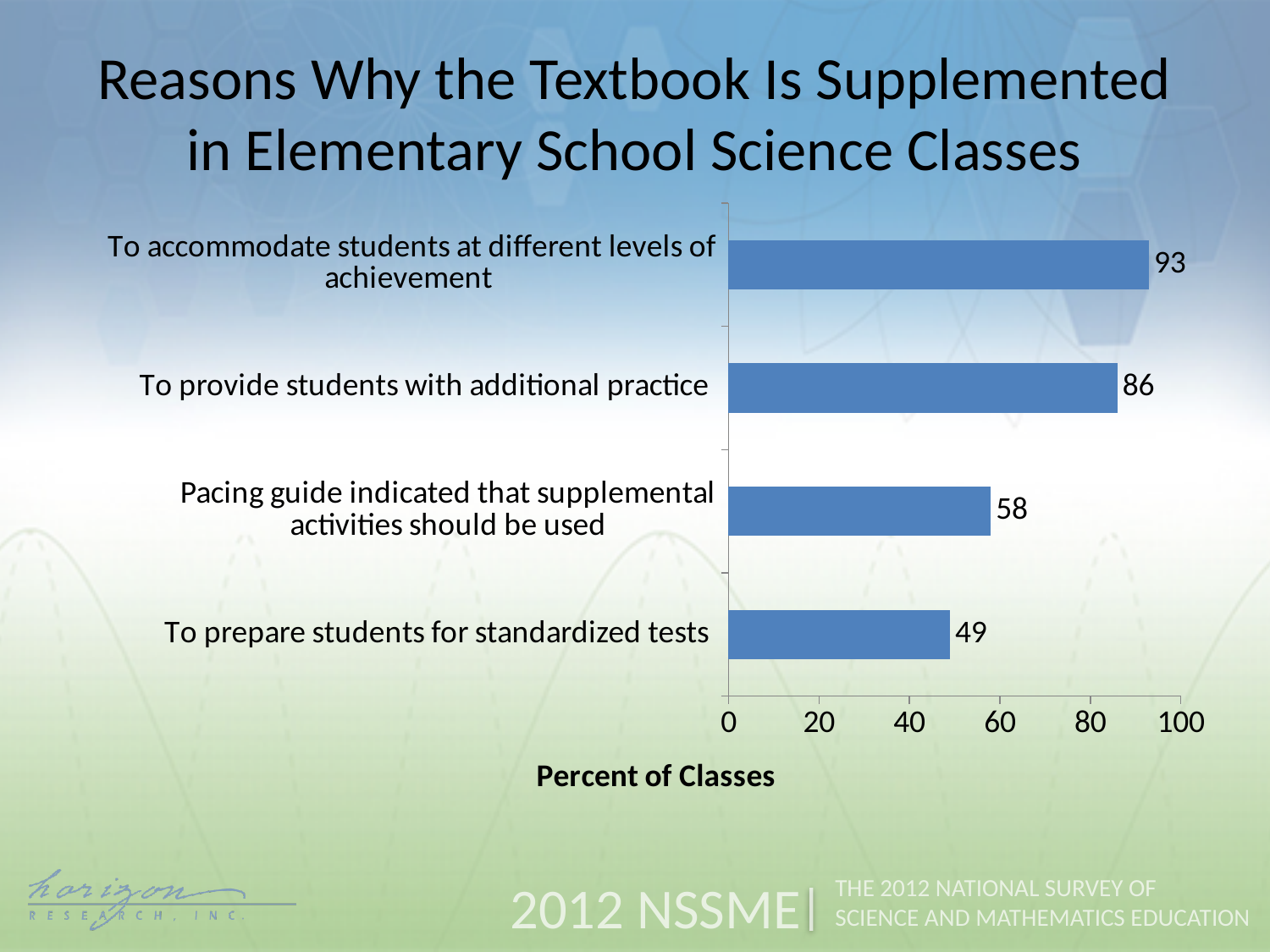
What is the difference in percent of classes between 'To accommodate students at different levels of achievement' and 'To prepare students for standardized tests'? 44 What is the label of the horizontal axis of the chart? Percent of Classes What kind of chart is shown on the slide? Bar chart What percent of classes supplement the textbook to provide students with additional practice? 86 What percent of classes supplement the textbook to prepare students for standardized tests? 49 What percent of classes supplement the textbook to accommodate students at different levels of achievement? 93 Is the value for 'To prepare students for standardized tests' greater or less than 60? less Which reason for supplementing the textbook has the highest percent of classes? To accommodate students at different levels of achievement Which reason for supplementing the textbook has the lowest percent of classes? To prepare students for standardized tests How many reasons are shown in the chart? 4 Which has a higher percent of classes: 'To provide students with additional practice' or 'Pacing guide indicated that supplemental activities should be used'? To provide students with additional practice What percent of classes supplement the textbook because the pacing guide indicated that supplemental activities should be used? 58